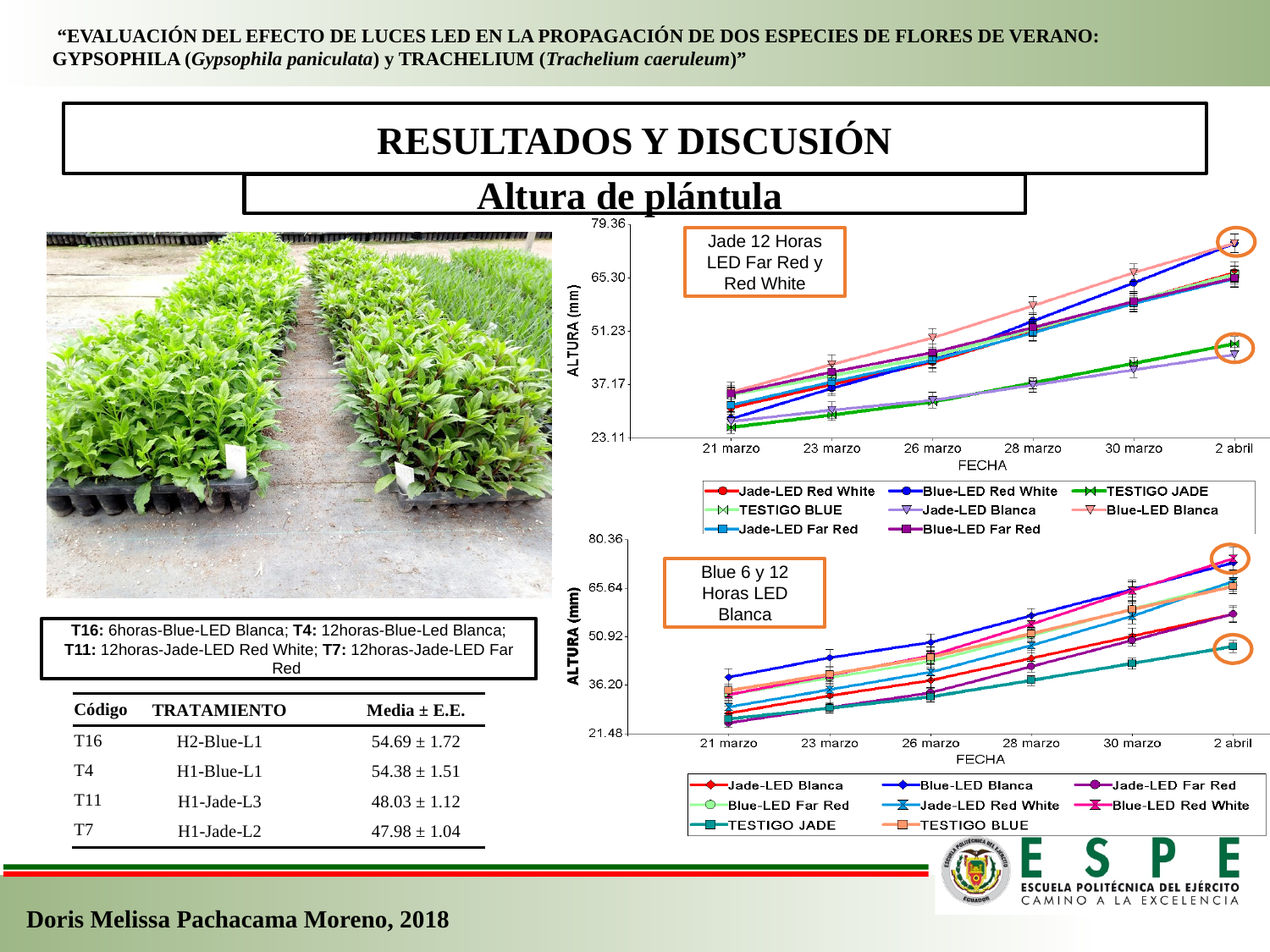
What kind of chart is the top chart on the slide? Line chart How many series does the legend of the bottom chart list? 8 In the bottom chart, is the value for TESTIGO JADE on 2 abril greater or less than 50.92? less In the bottom chart, which is larger on 2 abril: Blue-LED Red White or TESTIGO JADE? Blue-LED Red White What is the y-axis title of the top chart? ALTURA (mm) In the bottom chart, do the values for TESTIGO JADE rise or fall along the x axis? Rise In the top chart, is the value for TESTIGO JADE on 21 marzo greater or less than 37.17? less What kind of chart is the bottom chart on the slide? Line chart In the top chart, is the value for Blue-LED Blanca on 2 abril greater or less than 65.30? greater How many dates are shown on the x axis of the top chart? 6 In the top chart, do the values for Blue-LED Blanca rise or fall from 21 marzo to 2 abril? Rise How many series does the legend of the top chart list? 8